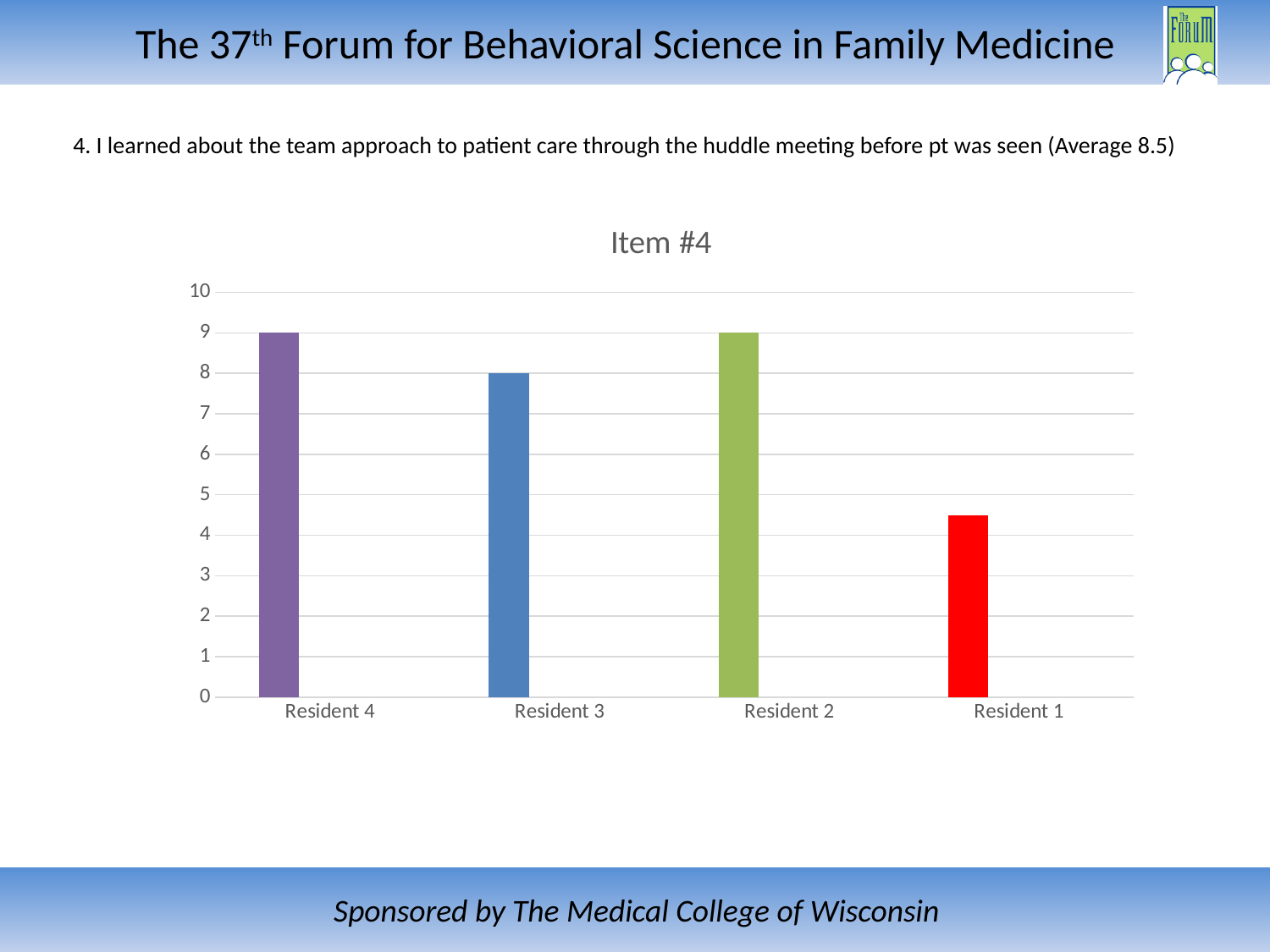
What is the difference between the values for Resident 4 and Resident 3? 1 What type of chart is shown on the slide? bar chart Which resident has the lowest value? Resident 1 What is the value for Resident 3? 8 What is the value for Resident 4? 9 Is the value for Resident 1 greater or less than 4? greater What is the value for Resident 2? 9 How many residents are shown on the x axis of the chart? 4 What colour is the bar for Resident 1? red Which is larger, the value for Resident 3 or the value for Resident 1? Resident 3 Is the value for Resident 1 greater or less than 5? less What is the title of the chart? Item #4